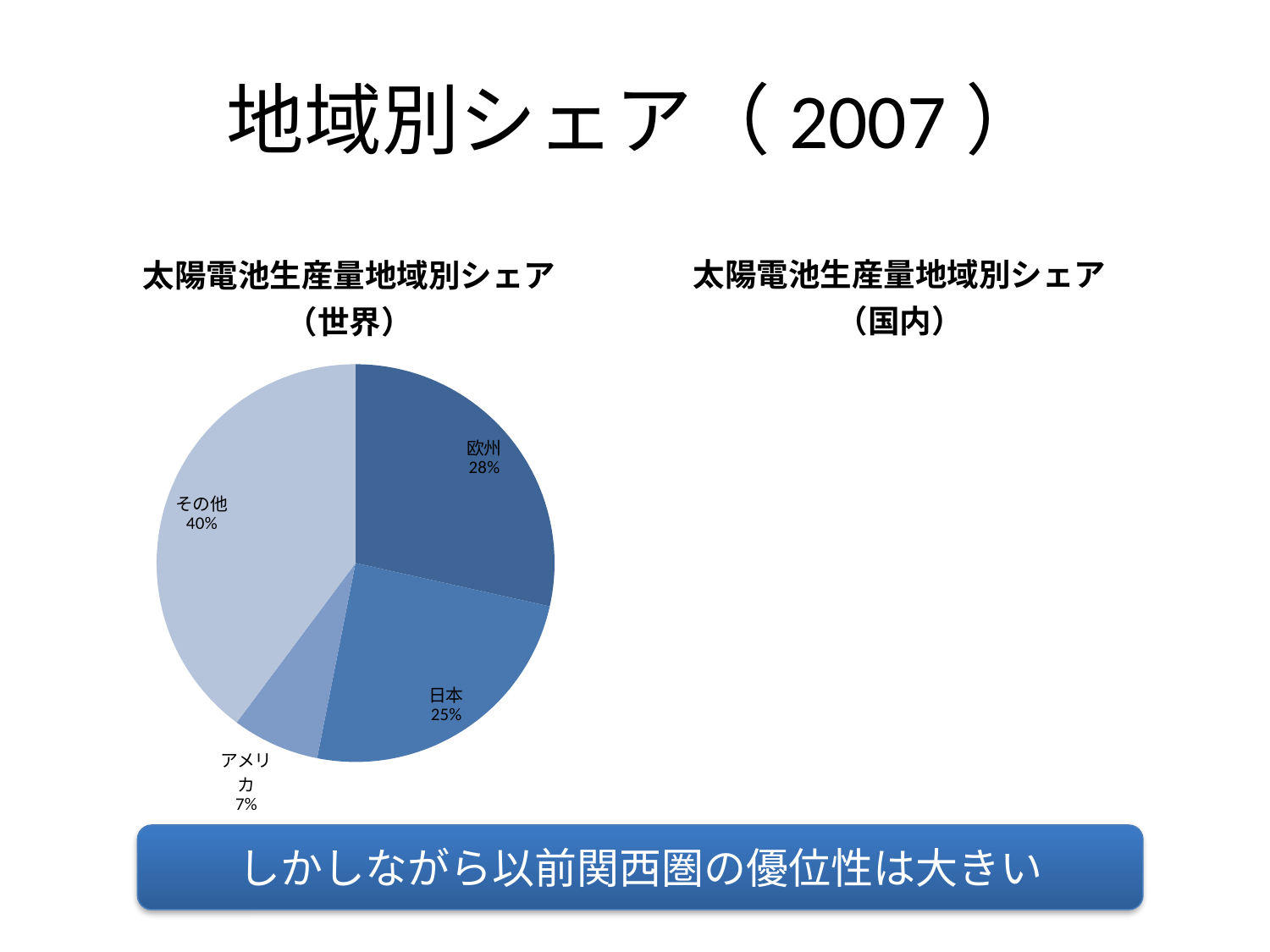
In the 太陽電池生産量地域別シェア（世界） chart, what is the difference between the shares of 欧州 and 日本? 3% In the 太陽電池生産量地域別シェア（世界） chart, what share does アメリカ have? 7% How many slices does the 太陽電池生産量地域別シェア（世界） chart have? 4 In the 太陽電池生産量地域別シェア（世界） chart, which region has the smallest share? アメリカ In the 太陽電池生産量地域別シェア（世界） chart, which region has the largest share? その他 What kind of chart is the 太陽電池生産量地域別シェア（世界） chart? Pie chart In the 太陽電池生産量地域別シェア（世界） chart, what share does 欧州 have? 28% In the 太陽電池生産量地域別シェア（世界） chart, which has a larger share, 欧州 or 日本? 欧州 In the 太陽電池生産量地域別シェア（世界） chart, what is the difference between the shares of その他 and アメリカ? 33% What is the title of the chart on the left side of the slide? 太陽電池生産量地域別シェア（世界） In the 太陽電池生産量地域別シェア（世界） chart, what share does 日本 have? 25% In the 太陽電池生産量地域別シェア（世界） chart, what share does その他 have? 40%